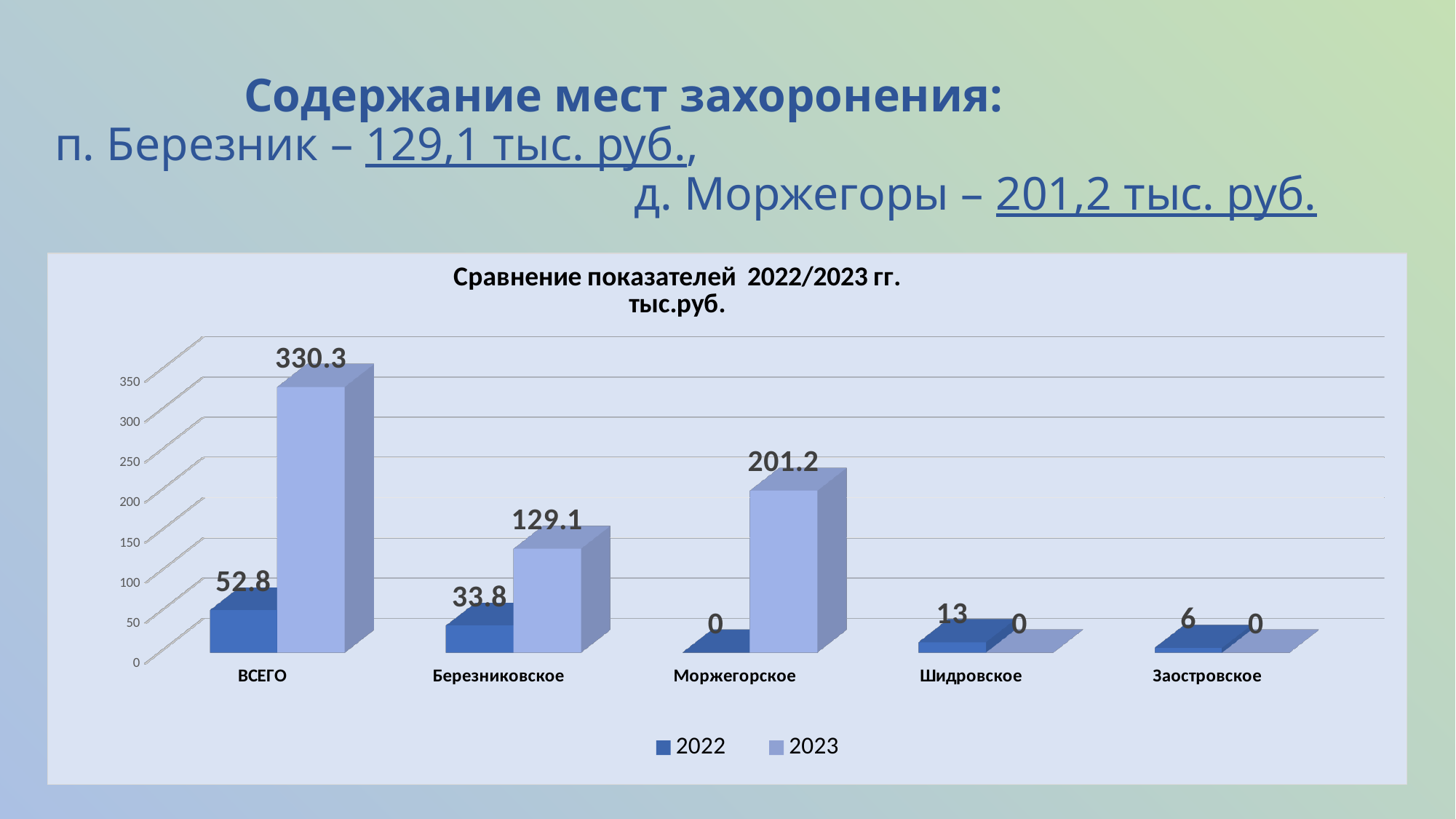
What kind of chart is shown on the slide? Bar chart How many series does the legend list? 2 What is the 2022 value for ВСЕГО? 52.8 What is the 2023 value for Березниковское? 129.1 Excluding ВСЕГО, which category has the lowest 2022 value? Моржегорское Which is larger: the 2022 value for Шидровское or the 2022 value for Заостровское? Шидровское What is the 2022 value for Шидровское? 13 Which category has the highest 2023 value? ВСЕГО What is the difference between the 2023 and 2022 values for Березниковское? 95.3 How many categories are shown on the x axis? 5 What is the title of the chart? Сравнение показателей 2022/2023 гг. тыс.руб. What is the 2023 value for Моржегорское? 201.2